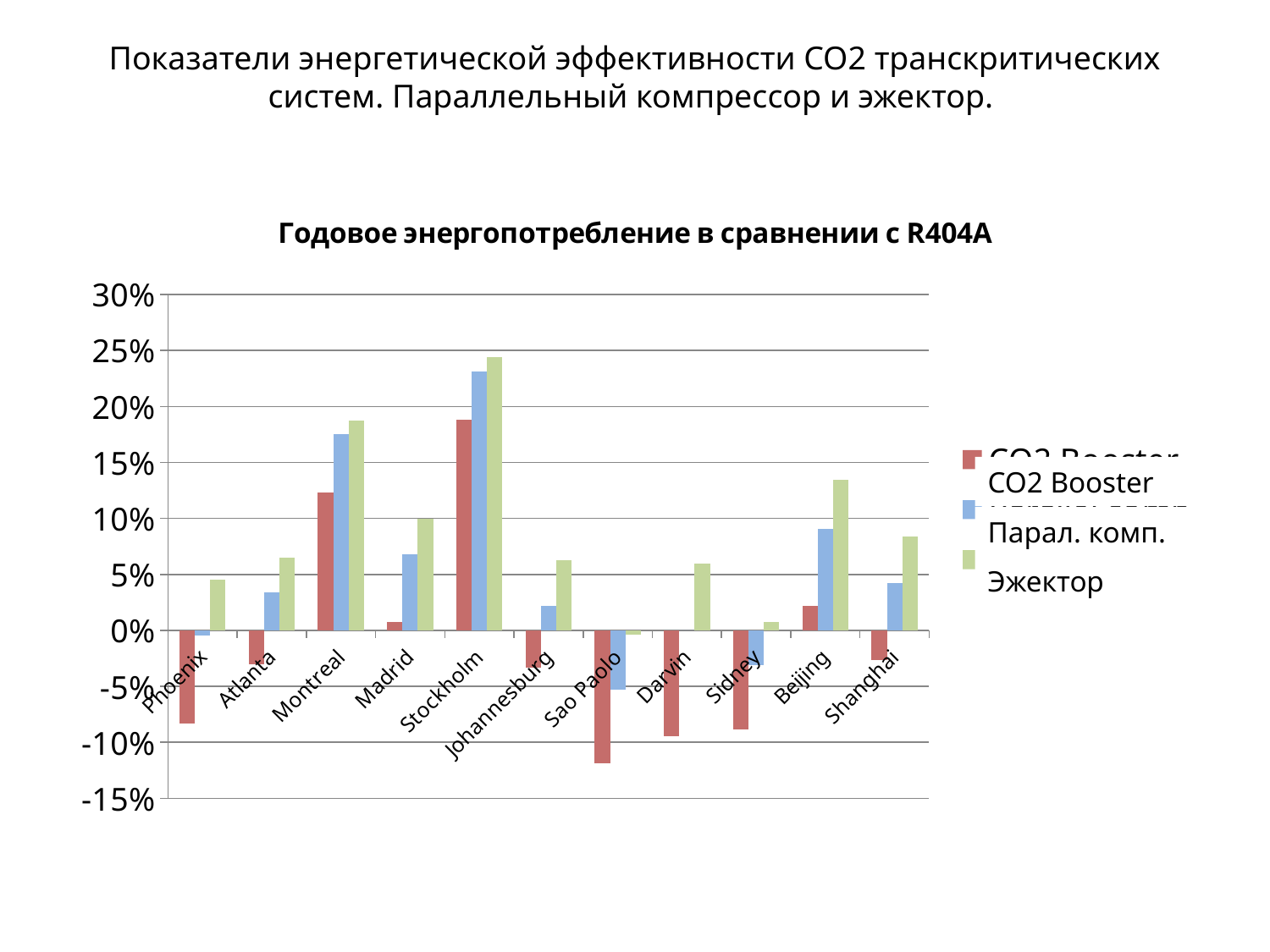
Is the CO2 Booster value for Phoenix greater or less than -5%? less Which city has the lowest value for the CO2 Booster series? Sao Paolo Which is larger, the Эжектор value for Montreal or the Эжектор value for Madrid? Montreal Which city has the highest value for the Эжектор series? Stockholm How many cities are shown on the x axis of the chart? 11 Which city has the lowest value for the Парал. комп. series? Sao Paolo Which is larger, the CO2 Booster value for Stockholm or the CO2 Booster value for Beijing? Stockholm Is the Эжектор value for Stockholm greater or less than 20%? greater What kind of chart is shown on the slide? Bar chart Is the Эжектор value for Beijing greater or less than 10%? greater How many series does the legend list? 3 What is the title of the chart? Годовое энергопотребление в сравнении с R404A